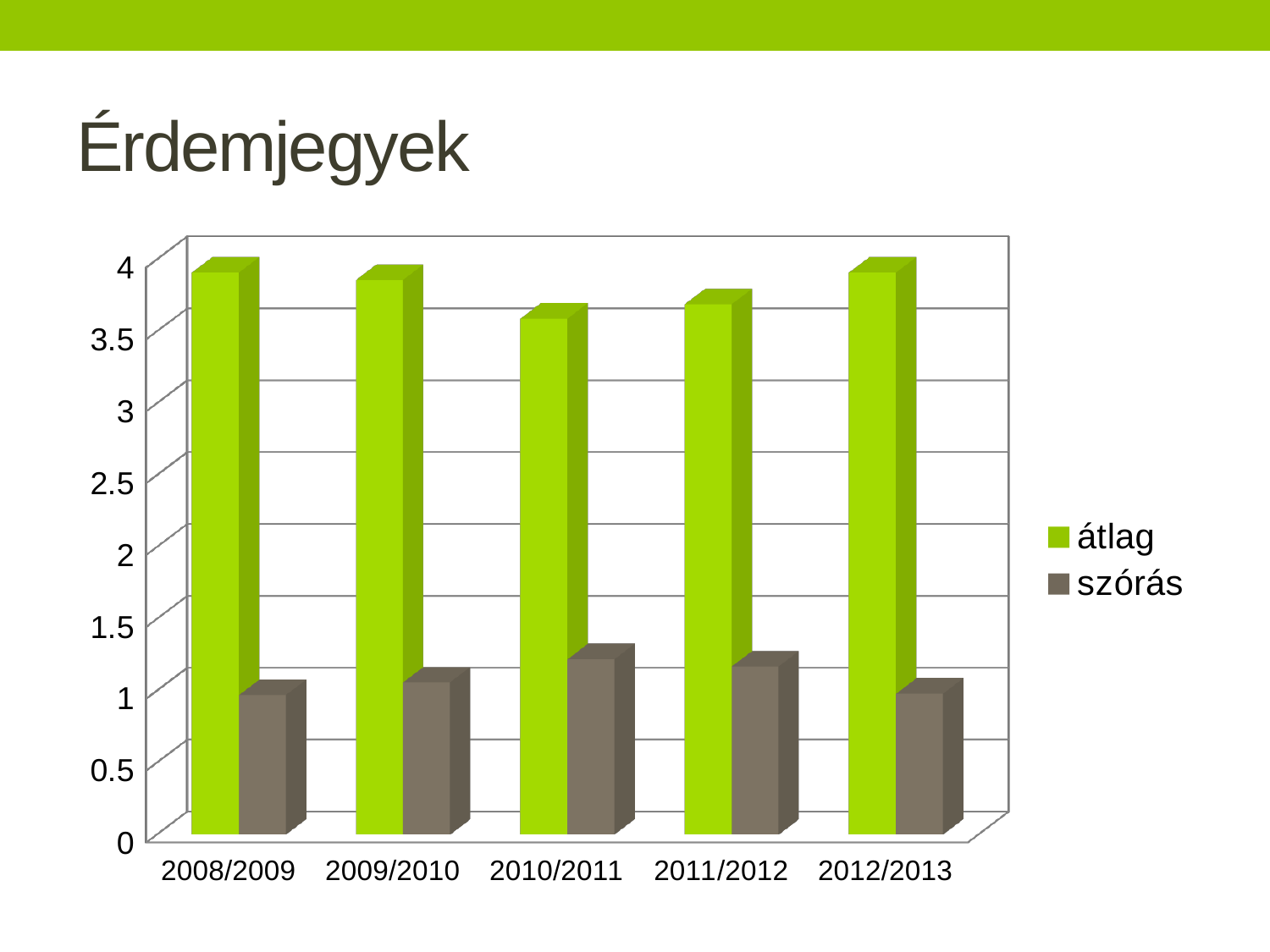
How many school years are shown on the x axis? 5 What is the title of the slide containing the chart? Érdemjegyek Which is larger, the átlag value for 2009/2010 or for 2010/2011? 2009/2010 In which school year is the átlag value lowest? 2010/2011 How many series does the legend list? 2 Is the szórás value for 2010/2011 greater or less than 1? greater Is the átlag value for 2008/2009 greater or less than 3.5? greater Which series is shown in green? átlag Is the szórás value for 2008/2009 greater or less than 1.5? less Does the szórás value rise or fall from 2008/2009 to 2010/2011? rise What kind of chart is shown on the slide? bar chart In which school year is the szórás value highest? 2010/2011